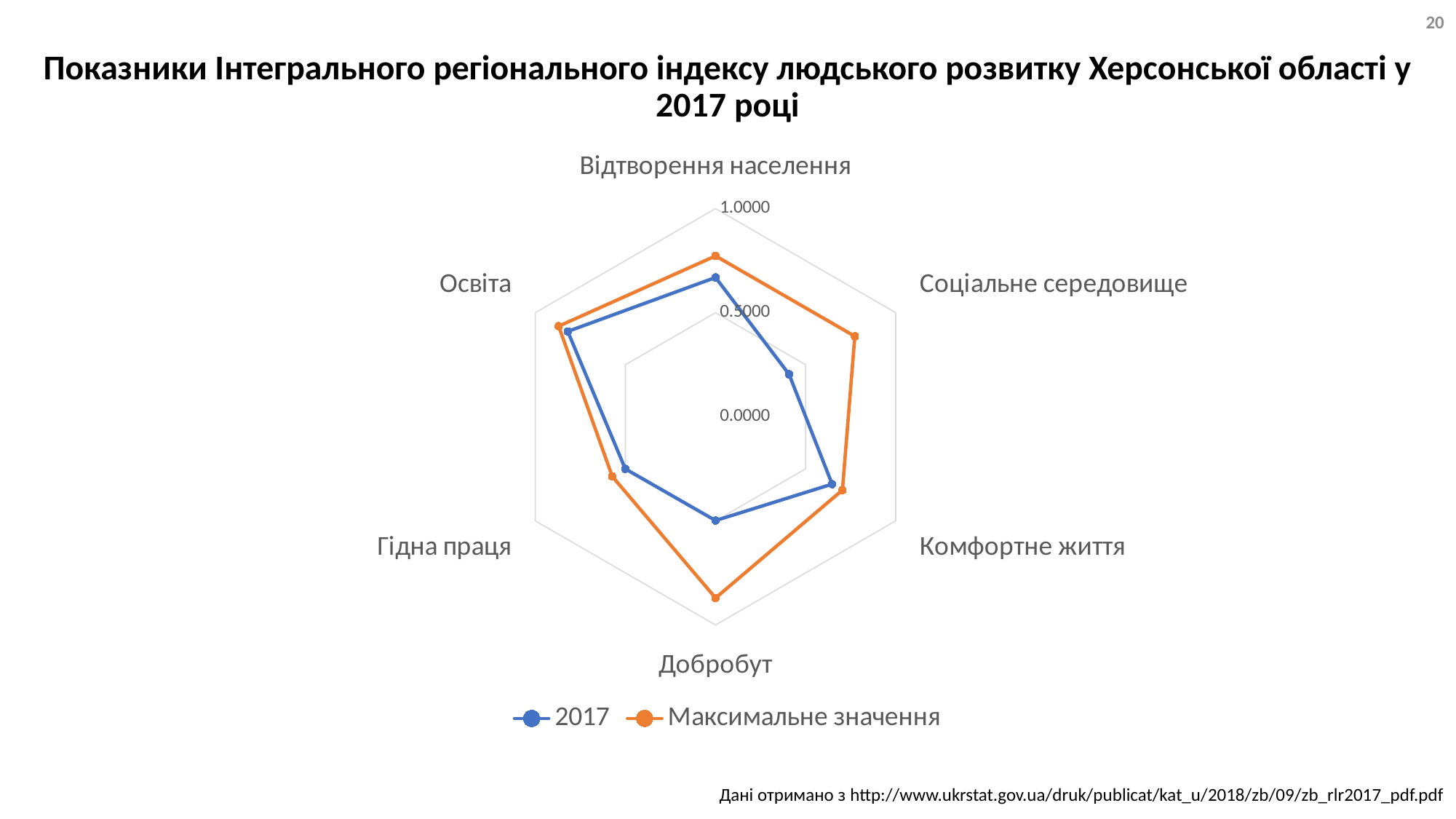
Is the 2017 value for Соціальне середовище greater or less than 0.5000? less Which category has the lowest value for the 2017 series? Соціальне середовище How many categories (axes) does the radar chart have? 6 What are the two series named in the legend? 2017 and Максимальне значення What is the highest value shown on the chart's axis scale? 1.0000 What kind of chart is shown on the slide? Radar chart How many series does the legend list? 2 Which category has the highest value for the 2017 series? Освіта Is the Максимальне значення value for Добробут greater or less than 0.5000? greater Is the 2017 value for Відтворення населення greater or less than 0.5000? greater For Соціальне середовище, which series has the larger value: 2017 or Максимальне значення? Максимальне значення